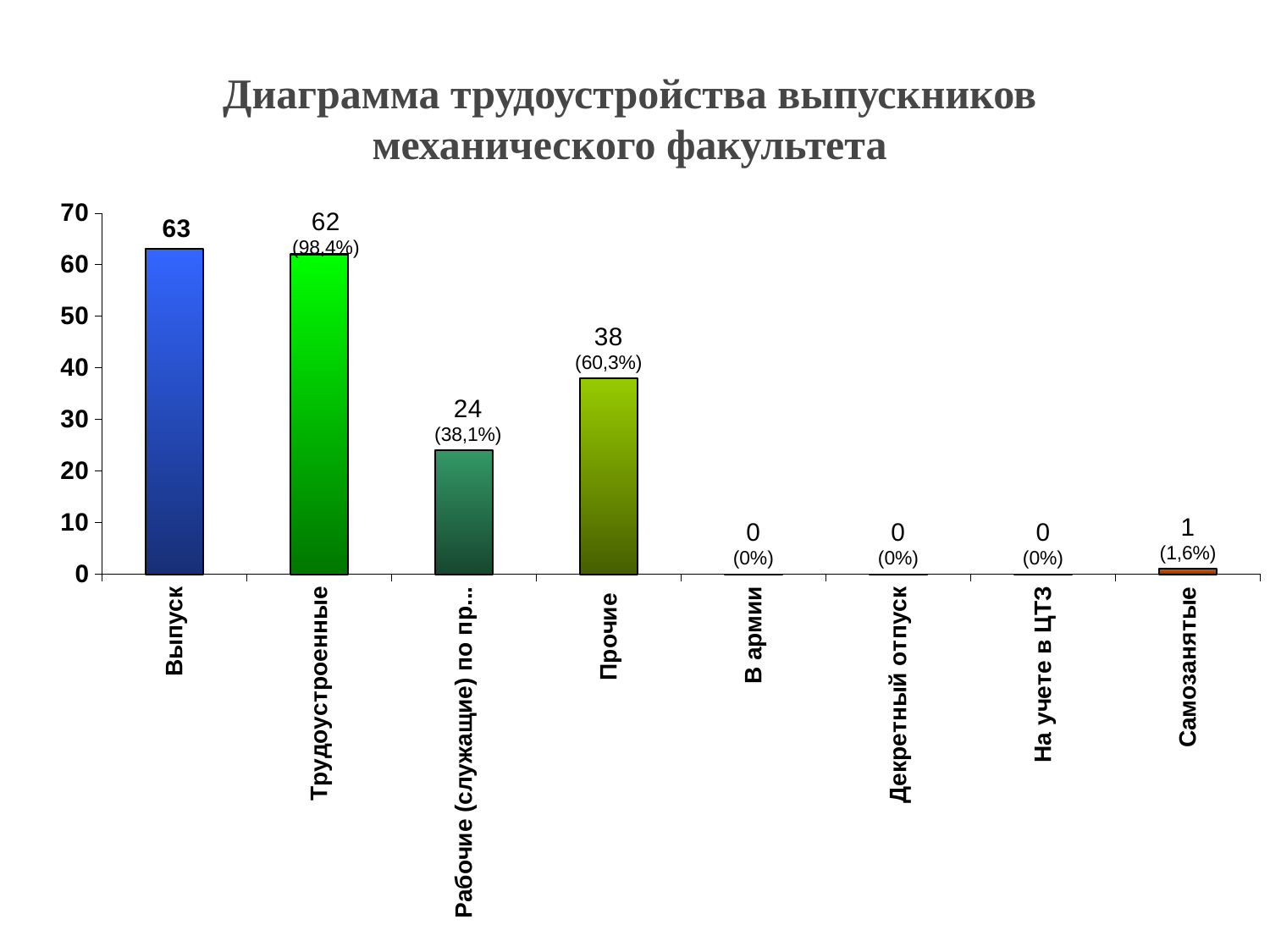
What is the difference between the values for Выпуск and Трудоустроенные? 1 Which category has the highest value? Выпуск What is the value for Самозанятые? 1 What is the value for Трудоустроенные? 62 How many categories are shown on the x axis? 8 Which is larger, the value for Прочие or the value for the third bar from the left (Рабочие (служащие) по пр...)? Прочие What is the value of the third bar from the left (Рабочие (служащие) по пр...)? 24 What is the value for Выпуск? 63 What percentage is shown for Прочие? 60,3% What type of chart is shown on the slide? bar chart How many categories have a value of 0? 3 What is the title of the chart? Диаграмма трудоустройства выпускников механического факультета